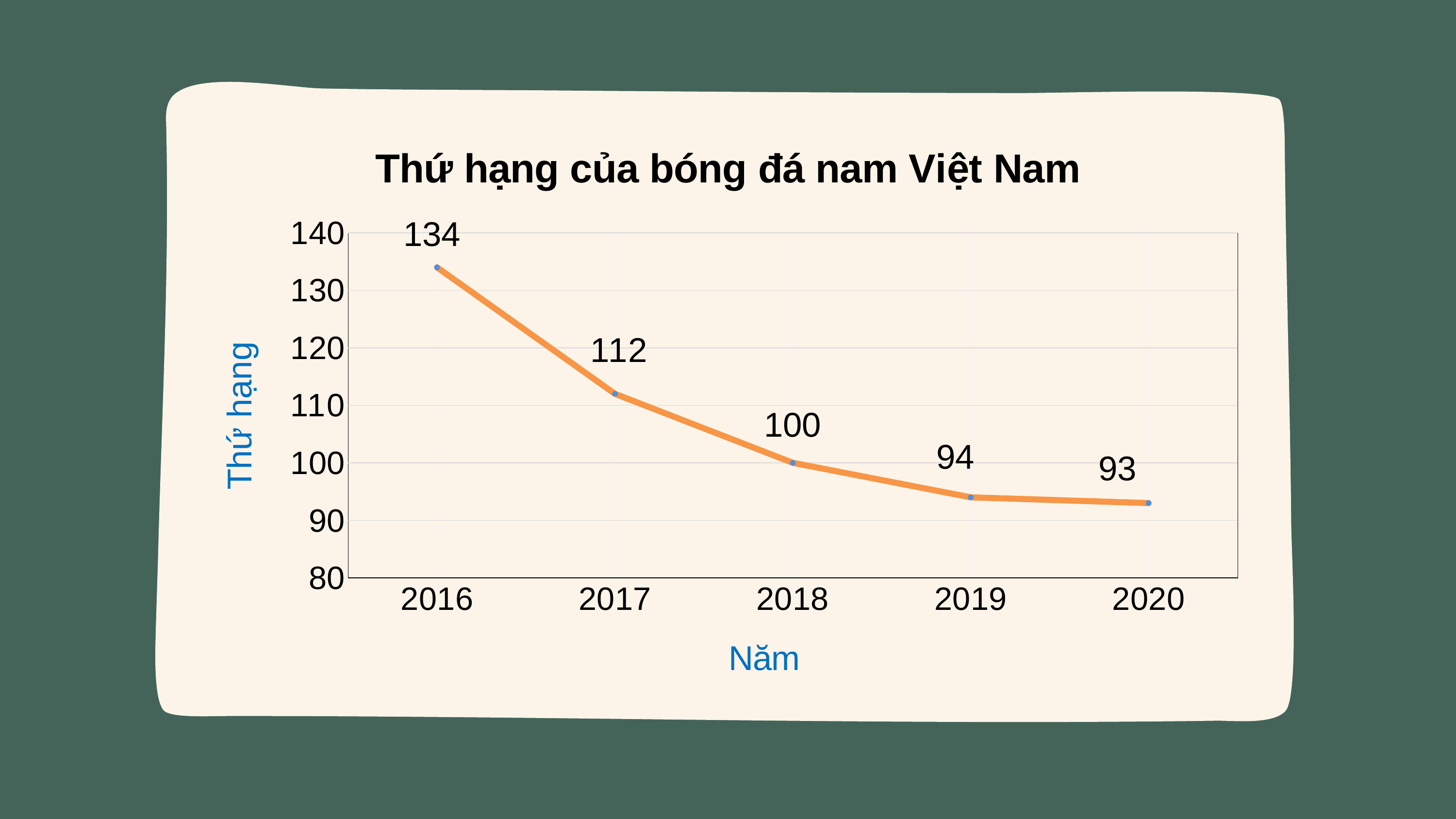
Which is larger, the value for 2017 or the value for 2019? 2017 Is the value for 2017 greater or less than 110? greater Do the values rise or fall from 2016 to 2020? fall Which year has the highest value? 2016 What kind of chart is this? line chart What is the value for 2020? 93 What is the value for 2018? 100 Which year has the lowest value? 2020 What is the value for 2016? 134 What is the difference between the values for 2016 and 2017? 22 How many years are plotted on the chart? 5 What is the difference between the values for 2018 and 2019? 6